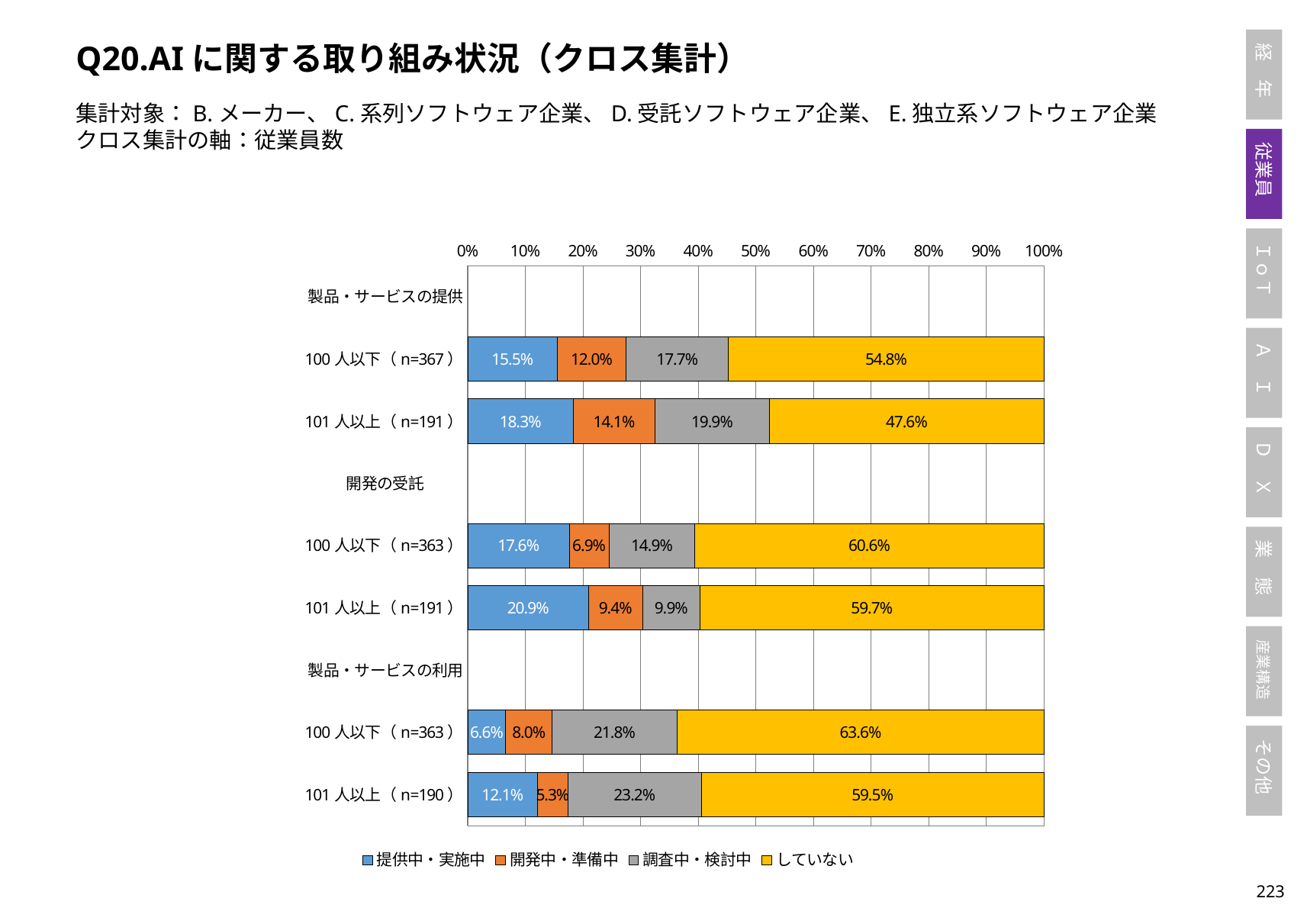
In the 開発の受託 group, what is the difference in 提供中・実施中 between 101人以上 (n=191) and 100人以下 (n=363)? 3.3% In the 製品・サービスの提供 group, which has the larger 調査中・検討中 value: 100人以下 (n=367) or 101人以上 (n=191)? 101人以上 (n=191) In the 製品・サービスの提供 group, what is the 提供中・実施中 value for 100人以下 (n=367)? 15.5% What kind of chart is shown on the slide? Stacked bar chart In the 開発の受託 group, what is the 開発中・準備中 value for 100人以下 (n=363)? 6.9% Which legend entry is shown in yellow? していない In the 製品・サービスの提供 group, what is the していない value for 101人以上 (n=191)? 47.6% How many series does the legend list? 4 In the 製品・サービスの利用 group, what is the 調査中・検討中 value for 101人以上 (n=190)? 23.2% Which bar has the lowest 提供中・実施中 value? 製品・サービスの利用 100人以下 (n=363) How many stacked bars are plotted in the chart? 6 Which bar has the highest していない value? 製品・サービスの利用 100人以下 (n=363)